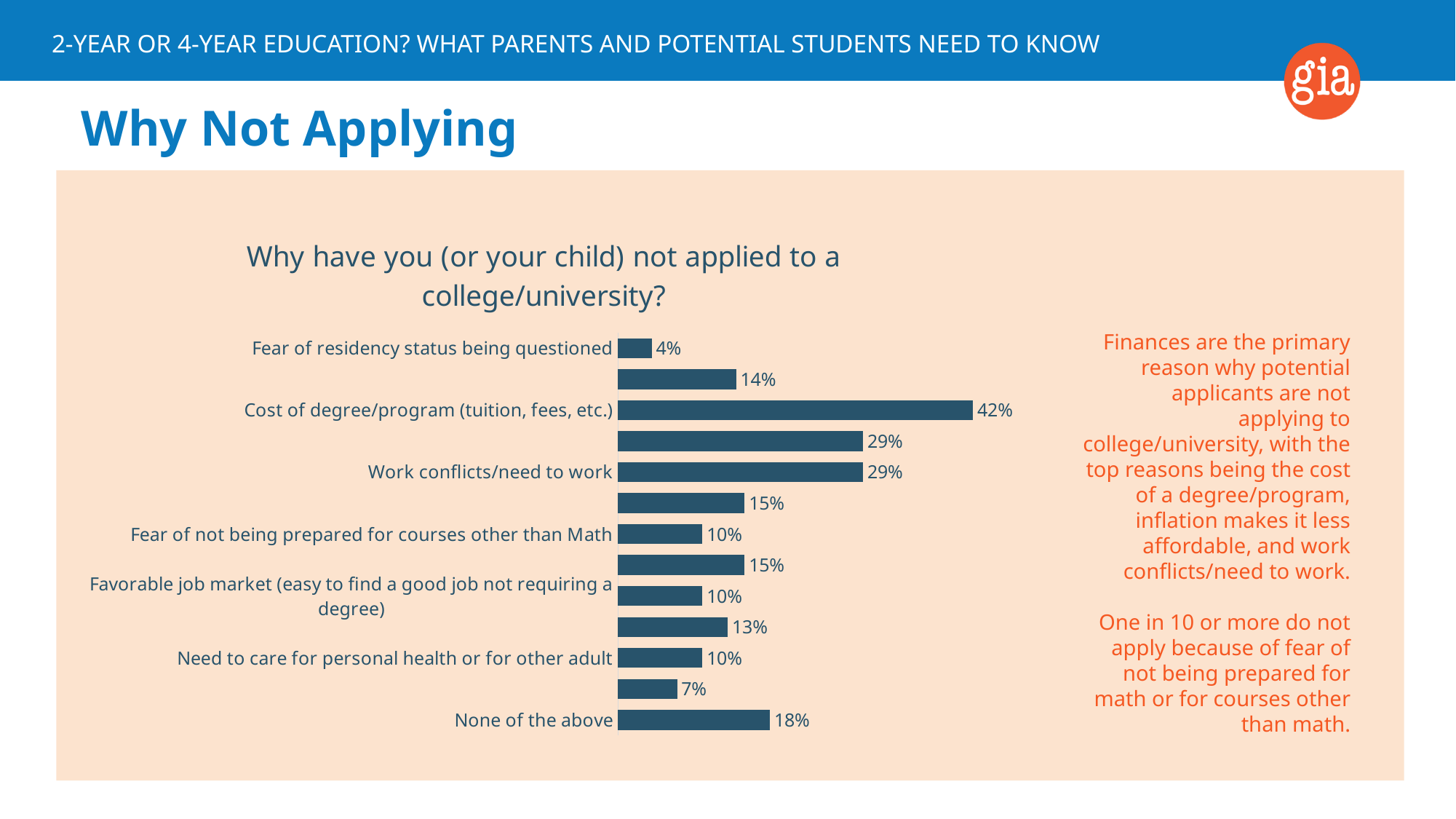
What is the title of the chart? Why have you (or your child) not applied to a college/university? What is the value for "Need to care for personal health or for other adult"? 10% What is the difference between the values for "Cost of degree/program (tuition, fees, etc.)" and "Work conflicts/need to work"? 13 percentage points What is the value for "Fear of residency status being questioned"? 4% What kind of chart is shown on the slide? Bar chart What is the value for "Work conflicts/need to work"? 29% Which labeled category has the lowest value? Fear of residency status being questioned What is the value for "Cost of degree/program (tuition, fees, etc.)"? 42% Which is larger: the value for "None of the above" or the value for "Favorable job market (easy to find a good job not requiring a degree)"? None of the above How many bars are plotted in the chart? 13 Which labeled category has the highest value? Cost of degree/program (tuition, fees, etc.) What is the value for "None of the above"? 18%